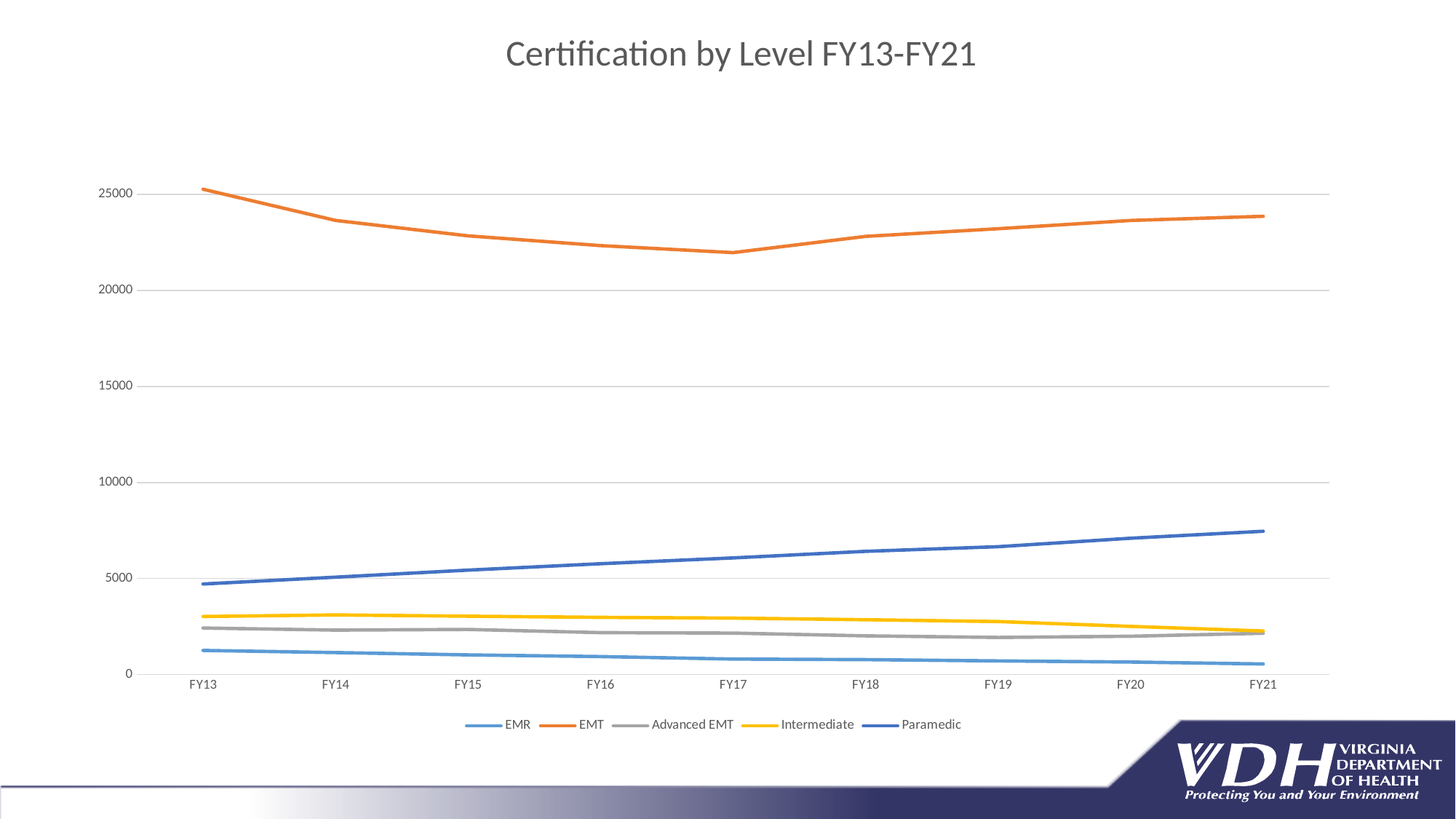
Does the Paramedic series rise or fall from FY13 to FY21? rise How many fiscal years are plotted along the x axis? 9 In FY13, which is larger: Intermediate or Advanced EMT? Intermediate What kind of chart is shown on the slide? line chart What is the title of the chart? Certification by Level FY13-FY21 Which series has the highest value in FY21? EMT Which series has the lowest value in FY21? EMR Is the value for Intermediate in FY13 greater or less than 5000? less How many series does the legend list? 5 Is the value for Paramedic in FY21 greater or less than 5000? greater Is the value for EMT in FY17 greater or less than 25000? less Does the EMR series rise or fall from FY13 to FY21? fall